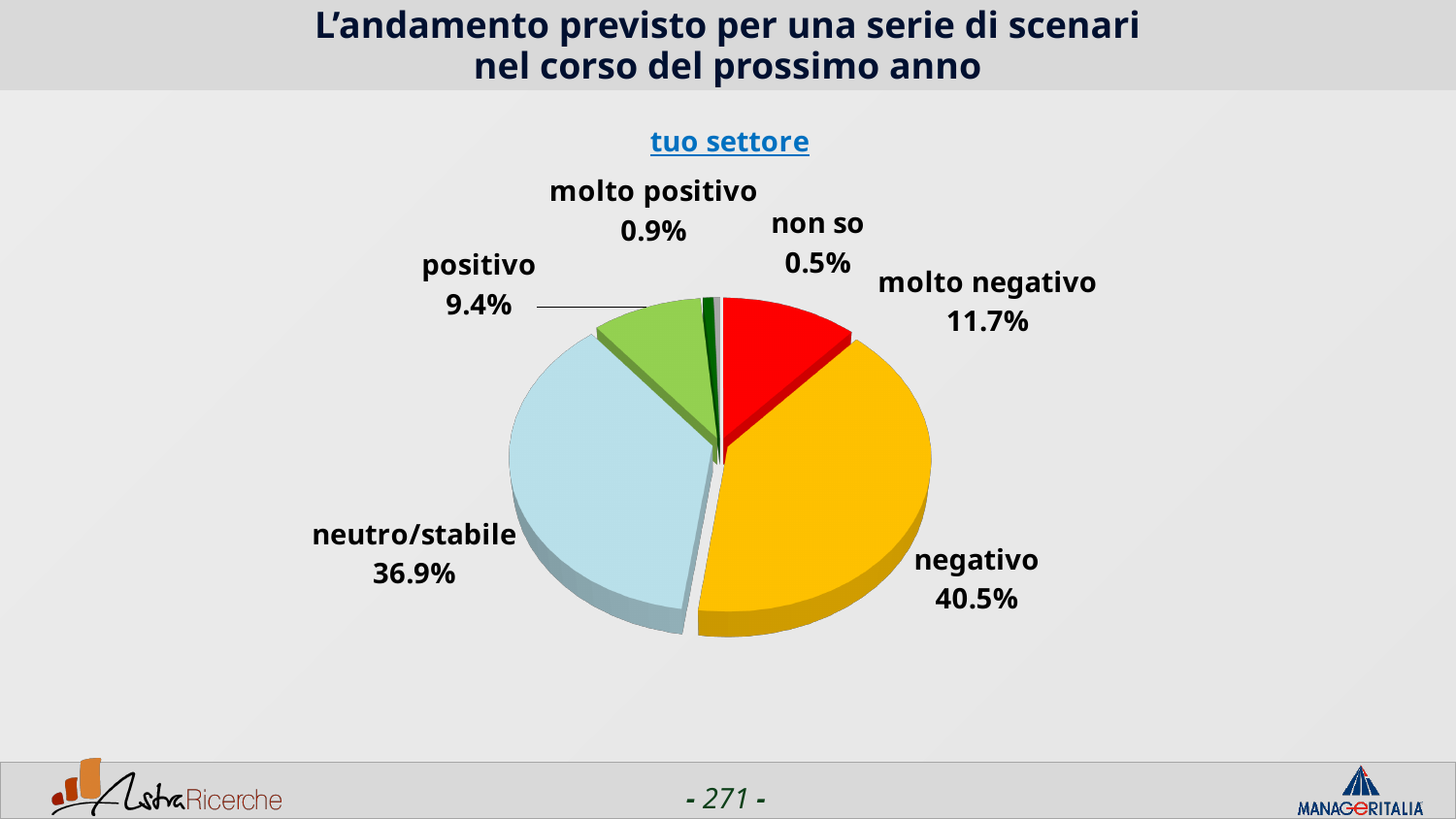
Which category has the largest share of the pie? negativo What percentage of the pie chart is labelled 'negativo'? 40.5% What kind of chart is shown on the slide? pie chart What is the subtitle shown above the pie chart? tuo settore What is the difference between the 'negativo' and 'neutro/stabile' shares? 3.6% What is the value shown for 'positivo'? 9.4% Which category has the smallest share of the pie? non so What is the value shown for 'molto negativo'? 11.7% How many categories are shown in the pie chart? 6 What is the combined share of 'positivo' and 'molto positivo'? 10.3% Which is larger, 'molto negativo' or 'positivo'? molto negativo What is the value shown for 'neutro/stabile'? 36.9%